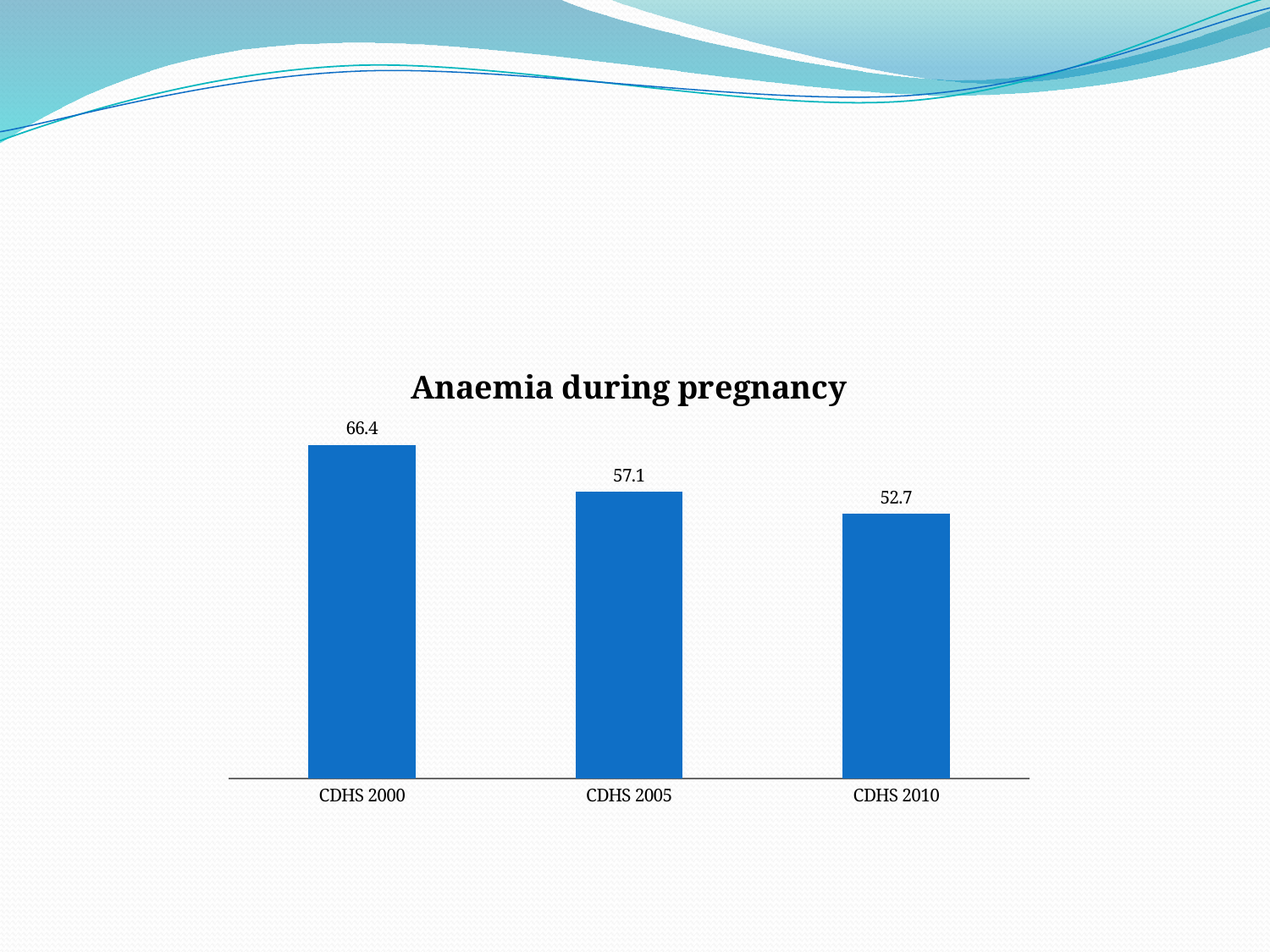
What is the value for CDHS 2000? 66.4 What is the difference between the values for CDHS 2000 and CDHS 2010? 13.7 What is the value for CDHS 2010? 52.7 Which category has the highest value? CDHS 2000 What is the value for CDHS 2005? 57.1 Do the values rise or fall from CDHS 2000 to CDHS 2010? Fall What kind of chart is shown? Bar chart What is the difference between the values for CDHS 2000 and CDHS 2005? 9.3 How many categories are shown on the chart? 3 Which category has the lowest value? CDHS 2010 What is the title of the chart? Anaemia during pregnancy Which is larger, the value for CDHS 2005 or CDHS 2010? CDHS 2005